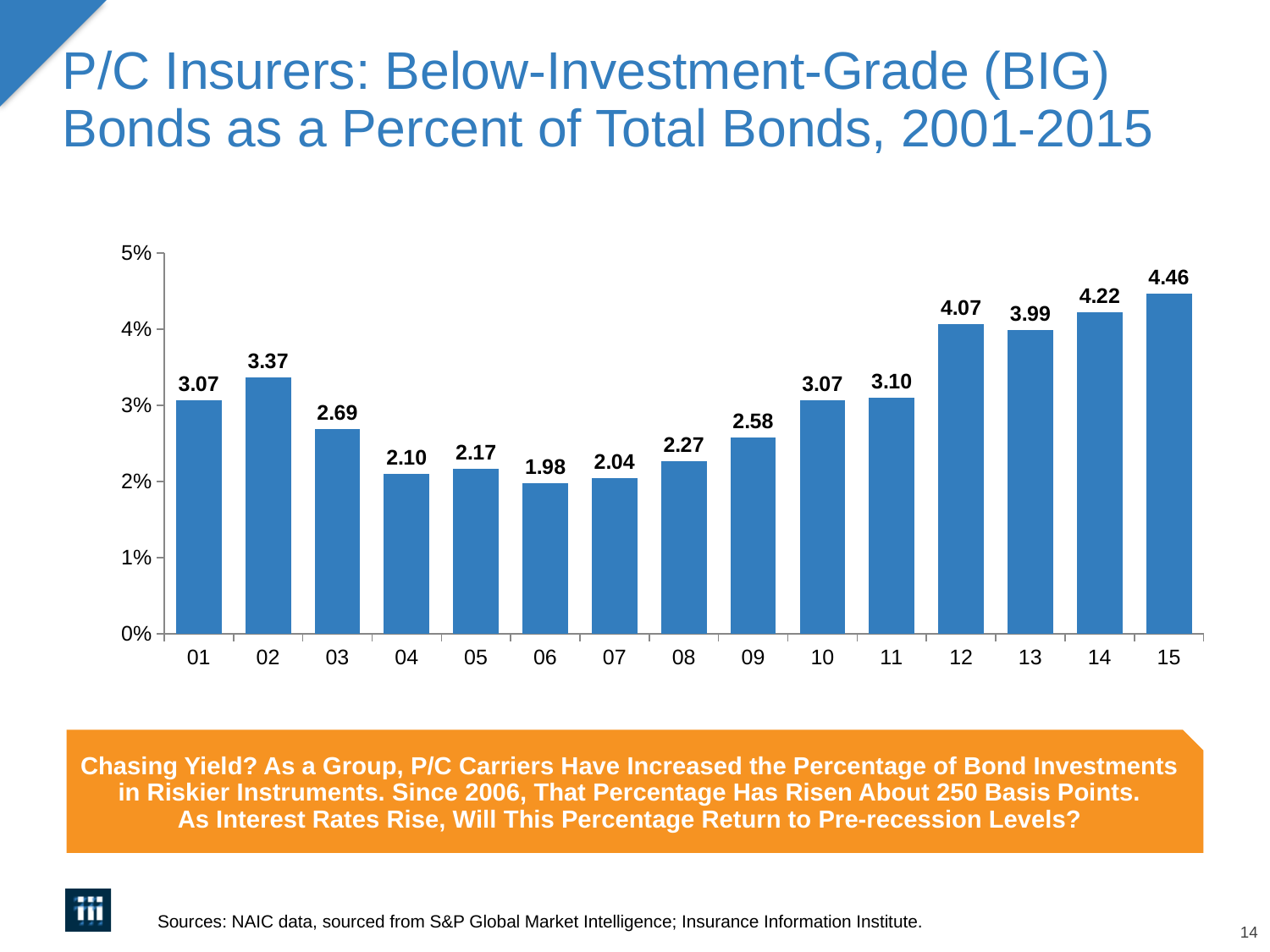
What is the value for 02? 3.37 What is the value for 15? 4.46 What is the difference between the values for 12 and 11? 0.97 Is the value for 13 greater or less than 3%? greater Do the values rise or fall from 06 to 15? rise What is the difference between the values for 15 and 06? 2.48 Which is larger, the value for 03 or the value for 09? 03 What is the value for 06? 1.98 What kind of chart is this? bar chart Which year has the highest value? 15 How many years are shown on the x axis? 15 Which year has the lowest value? 06